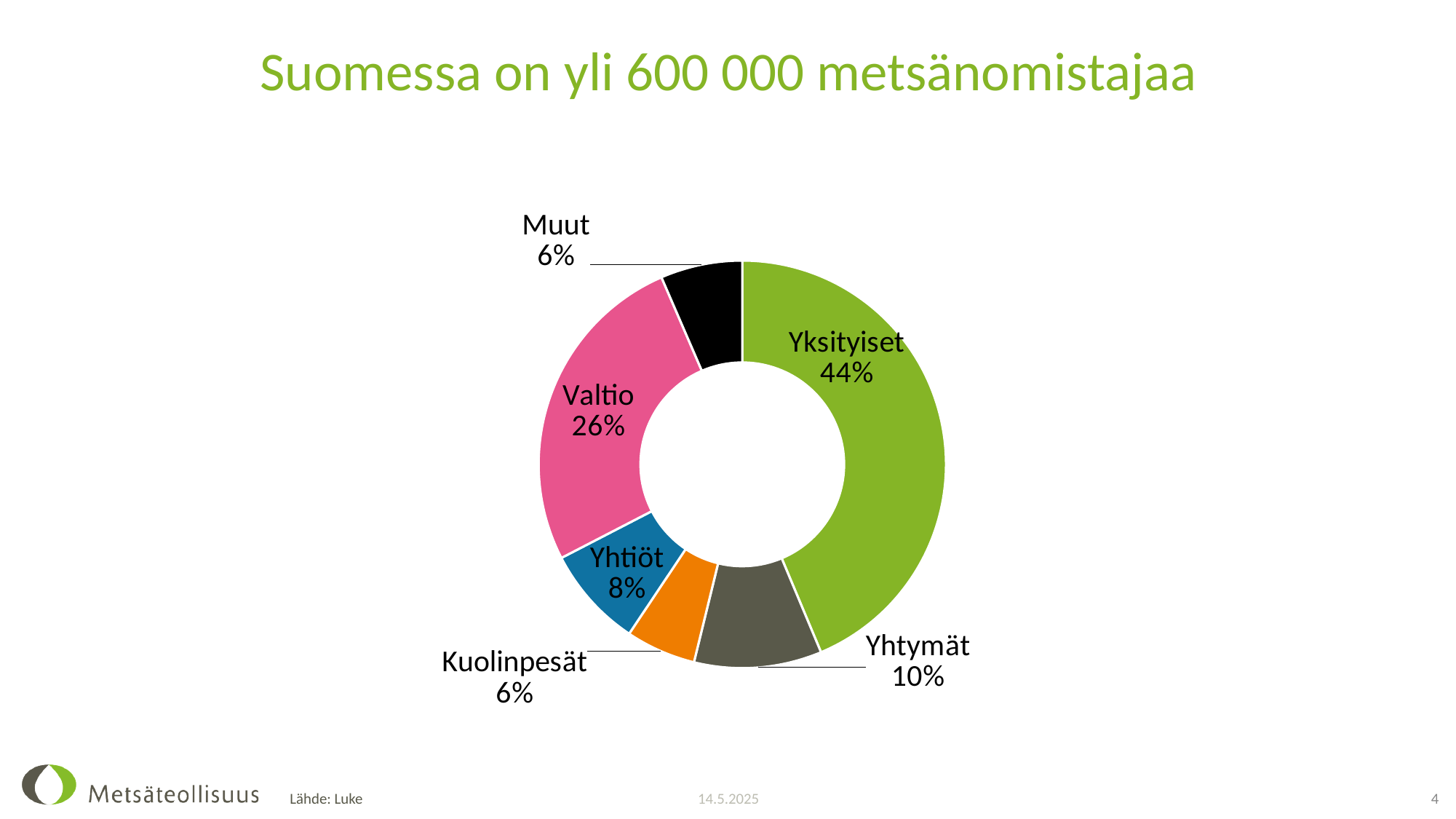
What percentage is shown for Yhtymät? 10% Which category has the largest share? Yksityiset What colour is the Valtio slice? Pink What kind of chart is shown on the slide? Pie chart (doughnut) Which is larger, the share of Yhtymät or the share of Yhtiöt? Yhtymät What is the value shown for Valtio? 26% What is the difference between the shares of Yksityiset and Valtio? 18 percentage points What is the value for Yhtiöt? 8% What is the combined share of Muut and Kuolinpesät? 12% What share of the chart does Yksityiset hold? 44% How many categories are shown in the chart? 6 What is the title of the slide? Suomessa on yli 600 000 metsänomistajaa